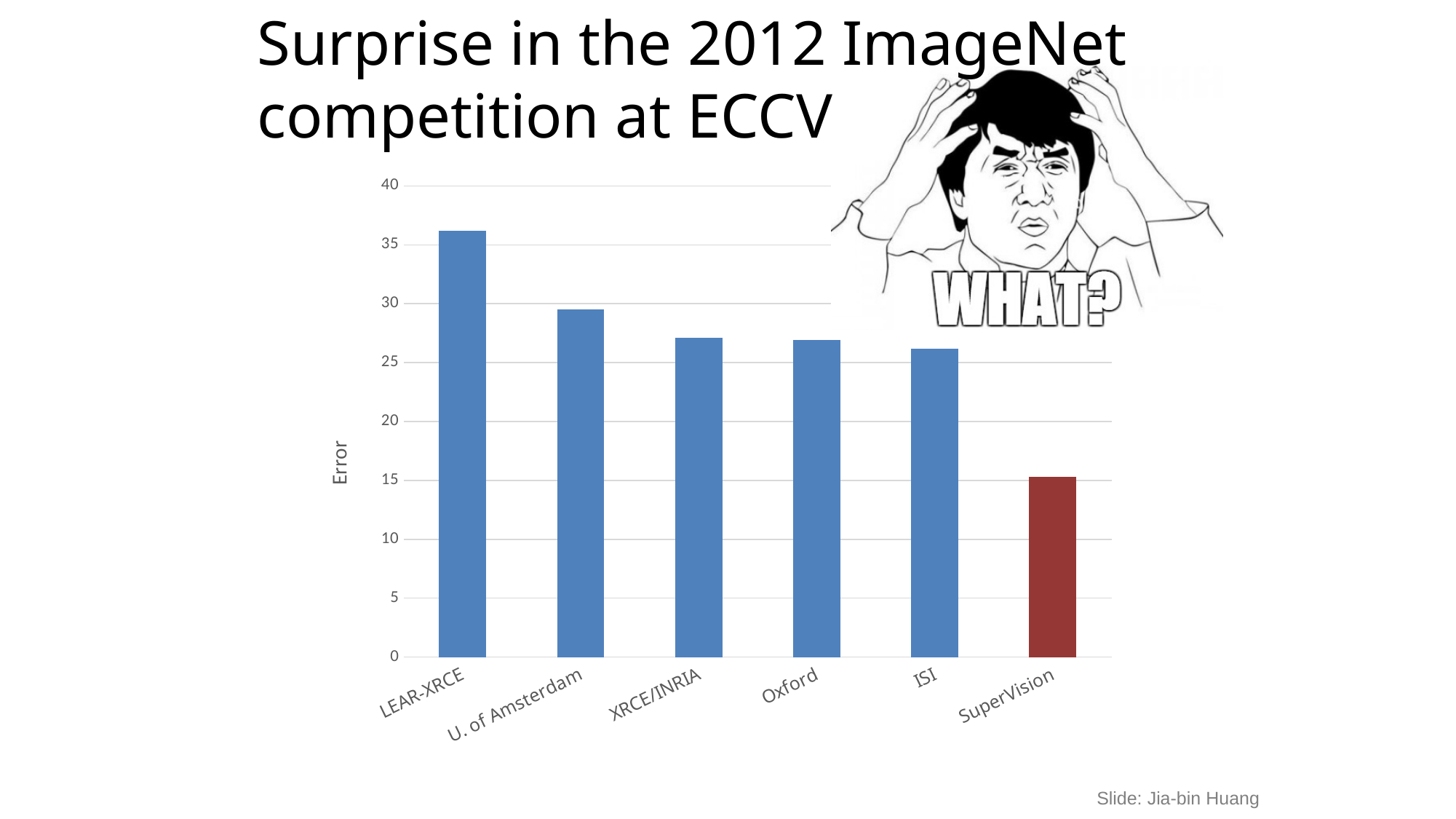
Is the error for ISI greater or less than 25? greater How many categories (teams) are shown on the x axis of the chart? 6 What kind of chart is shown on the slide? bar chart Is the error for SuperVision greater or less than 20? less Is the error for Oxford greater or less than 30? less Which has the larger error, U. of Amsterdam or XRCE/INRIA? U. of Amsterdam Which team has the lowest error in the chart? SuperVision Which bar in the chart is coloured differently (red) from the others? SuperVision Do the error values generally rise or fall from left to right along the x axis? fall Which team has the highest error in the chart? LEAR-XRCE